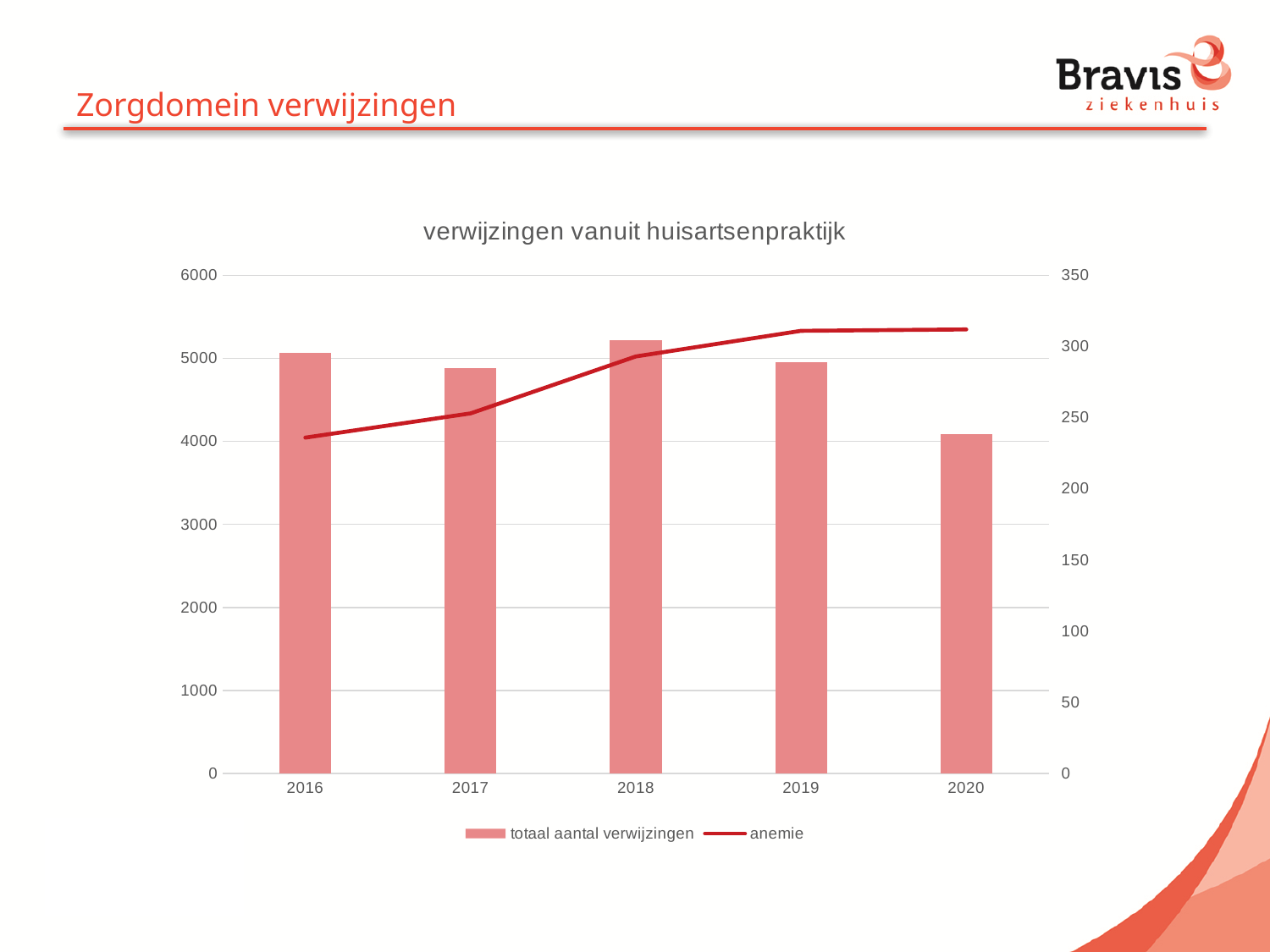
Which year has the highest bar for totaal aantal verwijzingen? 2018 Which year has the lowest bar for totaal aantal verwijzingen? 2020 How many series does the legend list? 2 Does the anemie line rise or fall from 2016 to 2019? rise Is the totaal aantal verwijzingen bar for 2017 greater or less than 4000? greater What is the title of the chart? verwijzingen vanuit huisartsenpraktijk Is the totaal aantal verwijzingen bar for 2020 greater or less than 5000? less Which is larger, the totaal aantal verwijzingen bar for 2016 or for 2020? 2016 How many years are shown on the x axis? 5 Which series is shown as a line rather than bars? anemie In which year is the anemie line at its lowest point? 2016